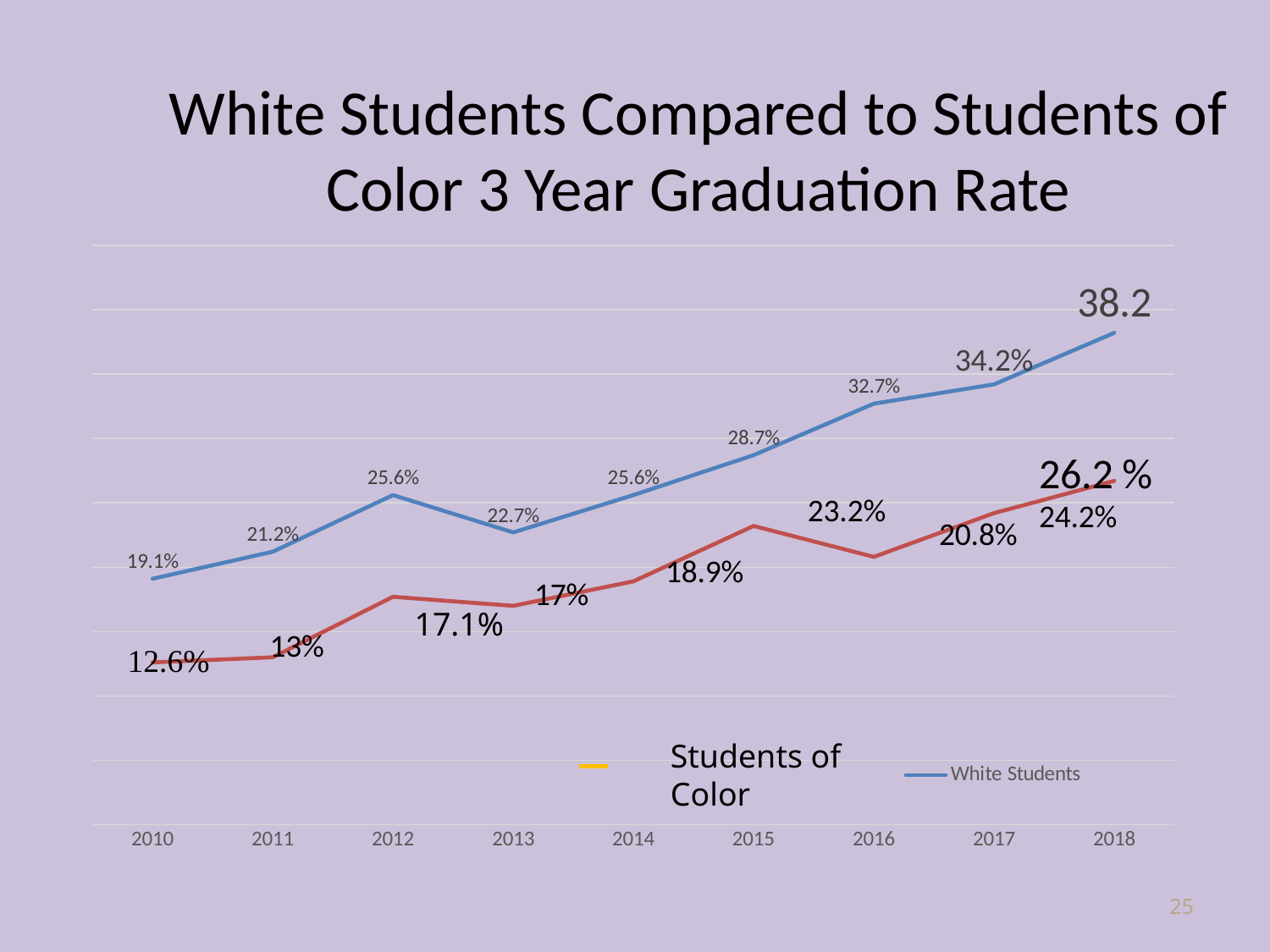
In which year is the White Students graduation rate highest? 2018 In which year is the Students of Color graduation rate lowest? 2010 How many years are shown on the x axis? 9 What kind of chart is shown on the slide? line chart Which series has the higher value in 2013, White Students or Students of Color? White Students What is the value for White Students in 2016? 32.7% What is the value for Students of Color in 2015? 23.2% What is the 3 year graduation rate for White Students in 2010? 19.1% How many series does the legend list? 2 What is the difference between the White Students and Students of Color rates in 2018? 12 Overall, do the Students of Color values rise or fall from 2010 to 2018? rise What is the 3 year graduation rate for Students of Color in 2018? 26.2 %